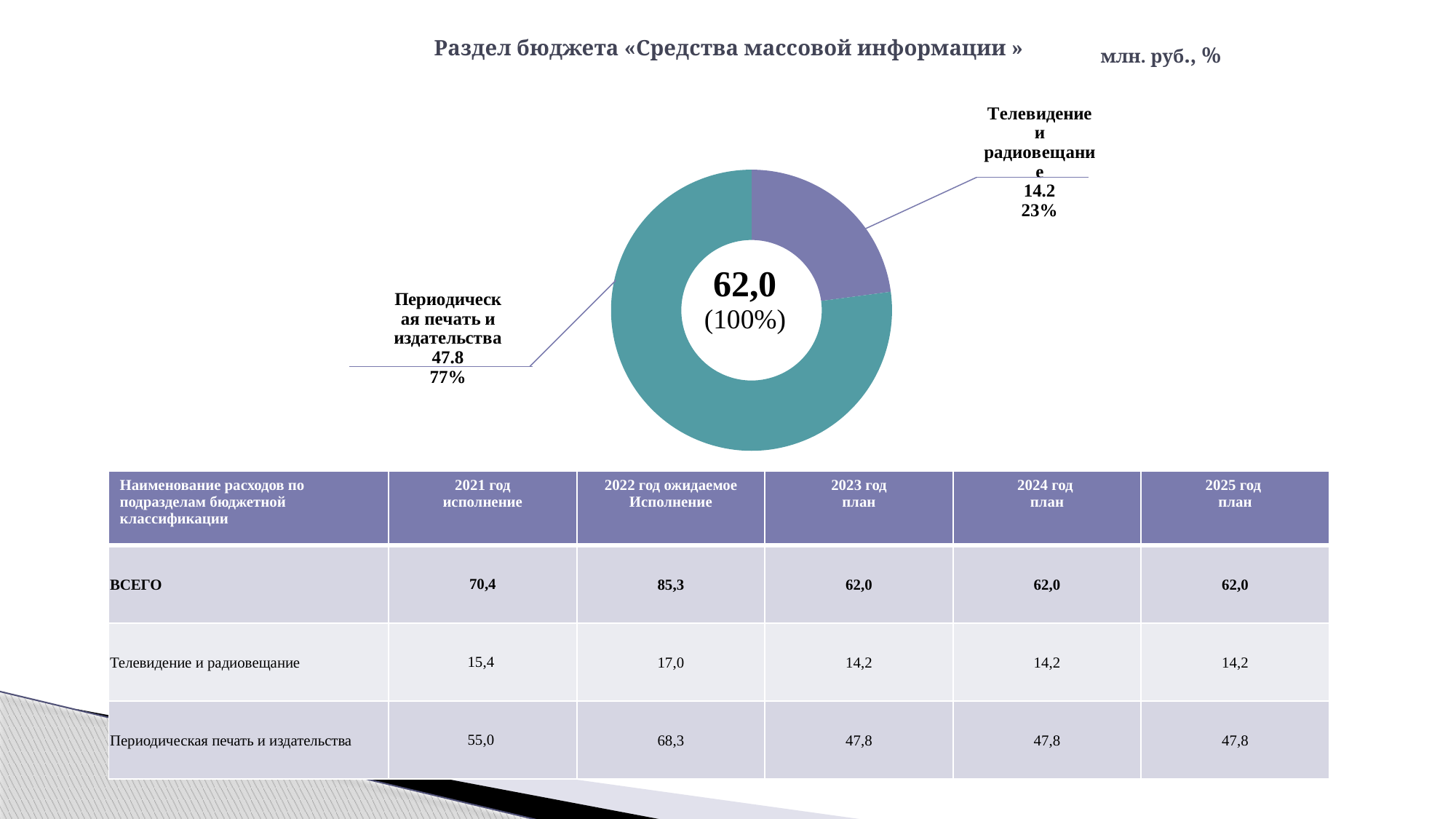
What is the difference between the values for «Периодическая печать и издательства» and «Телевидение и радиовещание» in the chart? 33.6 What is the value shown for «Телевидение и радиовещание» in the chart? 14.2 Which slice of the chart is the largest? Периодическая печать и издательства What is the value shown for «Периодическая печать и издательства» in the chart? 47.8 Which slice of the chart is the smallest? Телевидение и радиовещание What is the title of the chart on the slide? Раздел бюджета «Средства массовой информации » Which is larger in the chart: «Телевидение и радиовещание» or «Периодическая печать и издательства»? Периодическая печать и издательства What share of the pie does «Телевидение и радиовещание» represent? 23% What total value is shown in the centre of the chart? 62,0 (100%) What share of the pie does «Периодическая печать и издательства» represent? 77% How many slices does the chart have? 2 What type of chart is shown on the slide? Pie chart (donut)